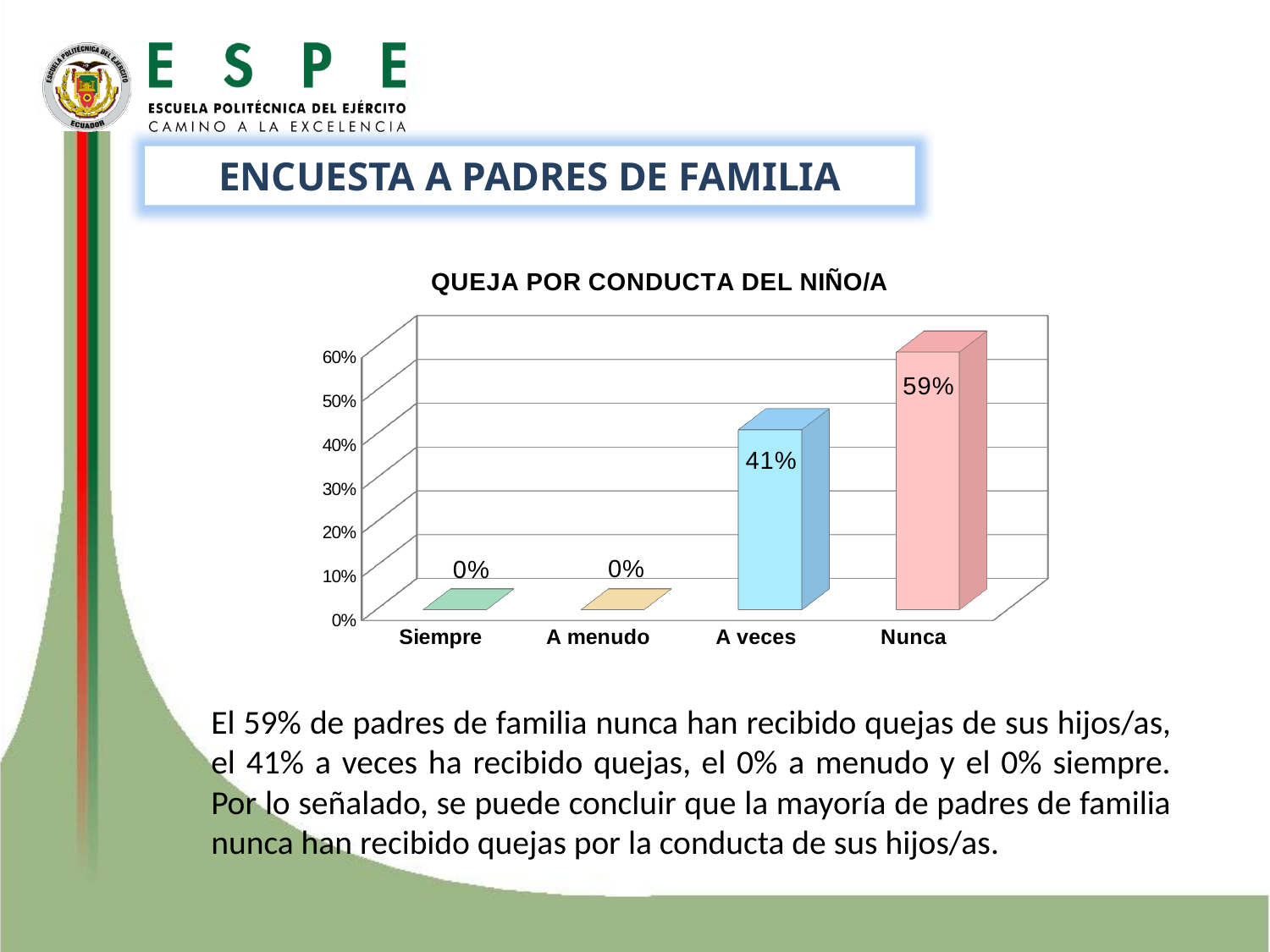
Which category has the highest value? Nunca How many categories are shown on the x axis? 4 Is the value for A veces greater or less than 50%? less Is the value for Nunca greater or less than 50%? greater Which is larger, the value for A veces or the value for Nunca? Nunca What is the value for A menudo? 0% What is the value for A veces? 41% What is the title of the chart? QUEJA POR CONDUCTA DEL NIÑO/A What kind of chart is shown on the slide? bar chart What is the difference between the values for Nunca and A veces? 18% What is the value for Siempre? 0% What is the value for Nunca? 59%